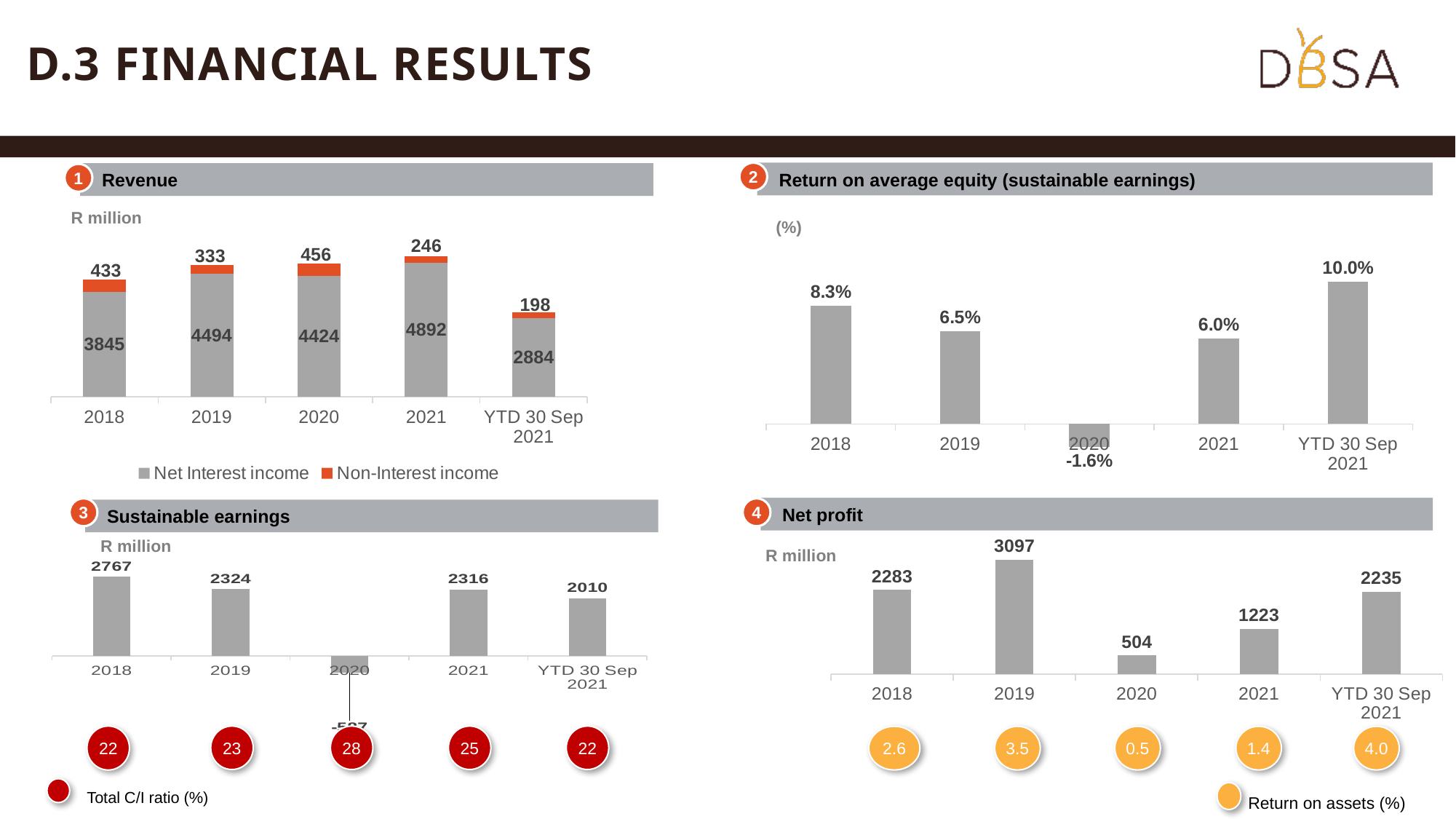
In the Net profit chart, which year has the highest net profit? 2019 In the Net profit chart, what is the difference between the 2019 and 2020 values? 2593 In the Sustainable earnings chart, what is the value for 2018? 2767 What kind of chart is the Net profit chart? Bar chart In the Return on average equity chart, which year has the lowest value? 2020 In the Revenue chart, what is the Net Interest income for 2021? 4892 In the Return on average equity chart, what is the value for YTD 30 Sep 2021? 10.0% In the Sustainable earnings chart, which is larger, the value for 2019 or the value for 2021? 2019 In the Return on average equity chart, what is the difference between the 2018 and 2019 values? 1.8% In the Revenue chart, what is the total revenue (Net Interest income plus Non-Interest income) for 2018? 4278 How many series does the legend of the Revenue chart list? 2 In the Revenue chart, what is the Non-Interest income for 2020? 456